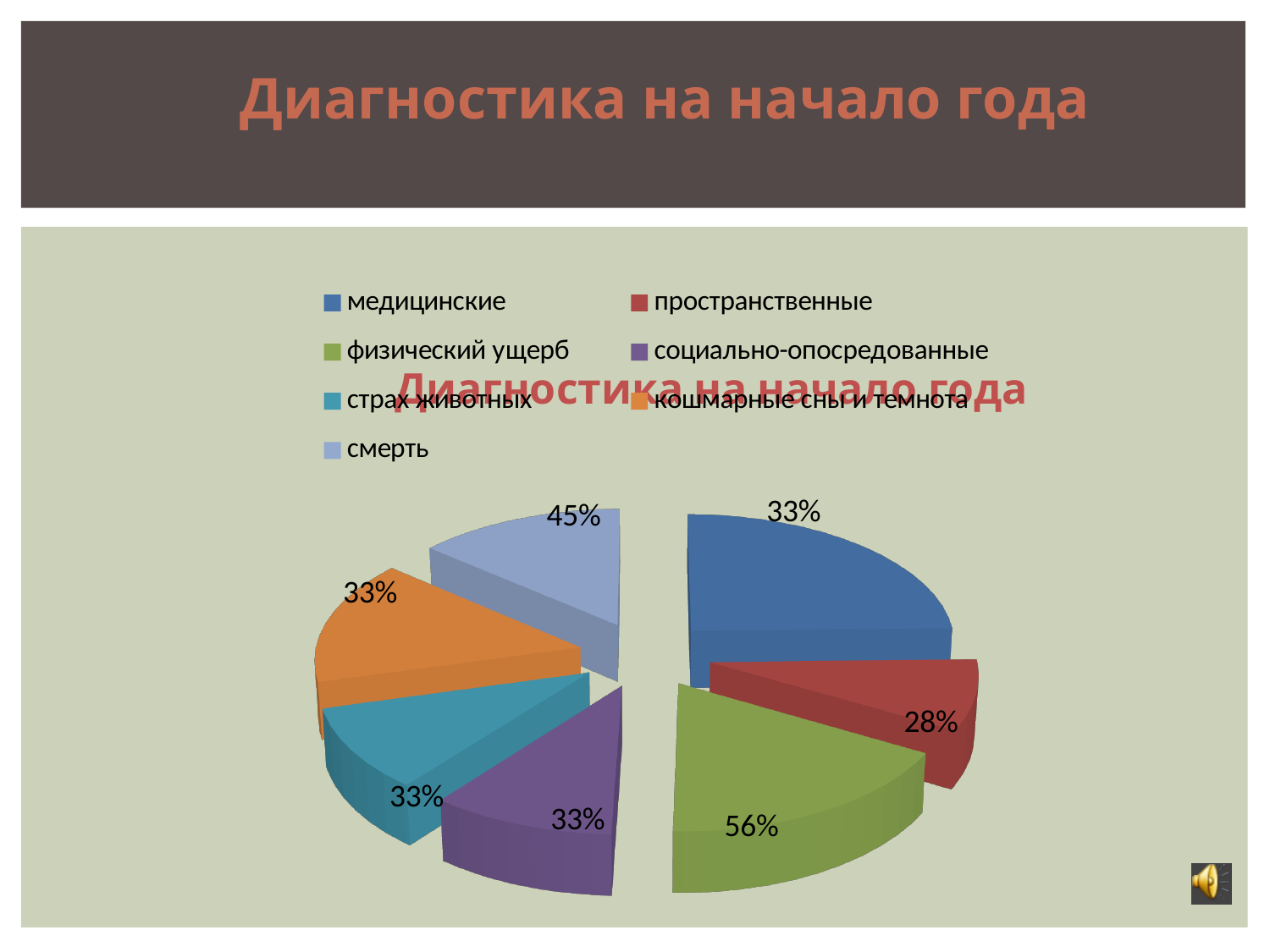
What is the difference between the labelled values for физический ущерб and пространственные? 28% How many categories does the legend of the pie chart list? 7 What kind of chart is shown on the slide? pie chart What value is labelled on the slice for пространственные? 28% Which category has the smallest labelled value in the pie chart? пространственные What colour is the slice for социально-опосредованные? purple What value is labelled on the slice for физический ущерб? 56% Which category has the largest labelled value in the pie chart? физический ущерб What value is labelled on the slice for кошмарные сны и темнота? 33% What value is labelled on the slice for смерть? 45% Which has the larger labelled value: смерть or страх животных? смерть What value is labelled on the slice for медицинские? 33%